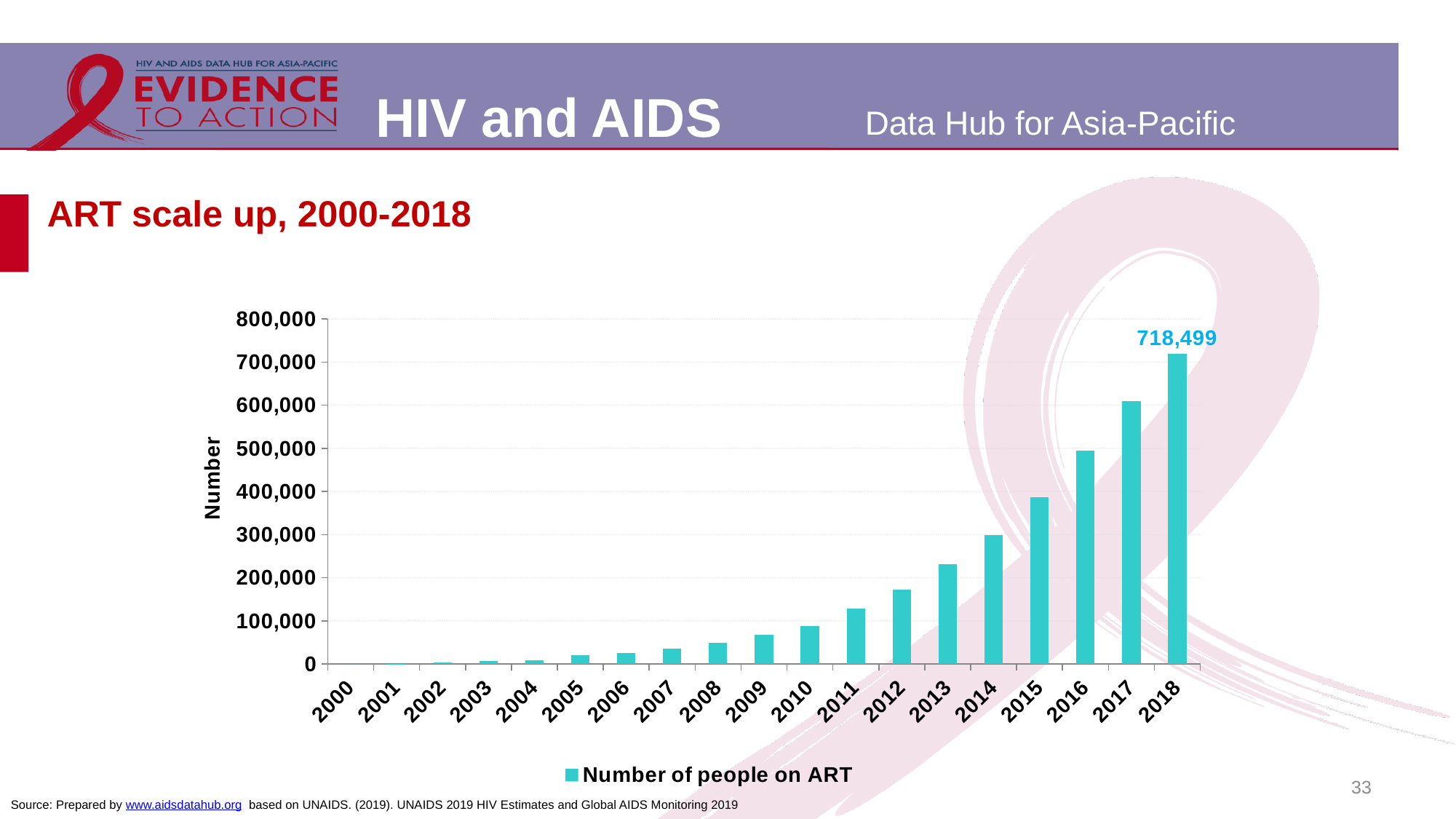
How many series does the legend list? 1 Does the number of people on ART rise or fall from 2000 to 2018? rise Is the number of people on ART in 2010 greater or less than 100,000? less What is the number of people on ART in 2018? 718,499 What kind of chart is shown on the slide? bar chart Which year has more people on ART, 2015 or 2013? 2015 Is the number of people on ART in 2014 greater or less than 200,000? greater Which year has the highest number of people on ART? 2018 Is the number of people on ART in 2017 greater or less than 600,000? greater How many years are shown on the x axis of the chart? 19